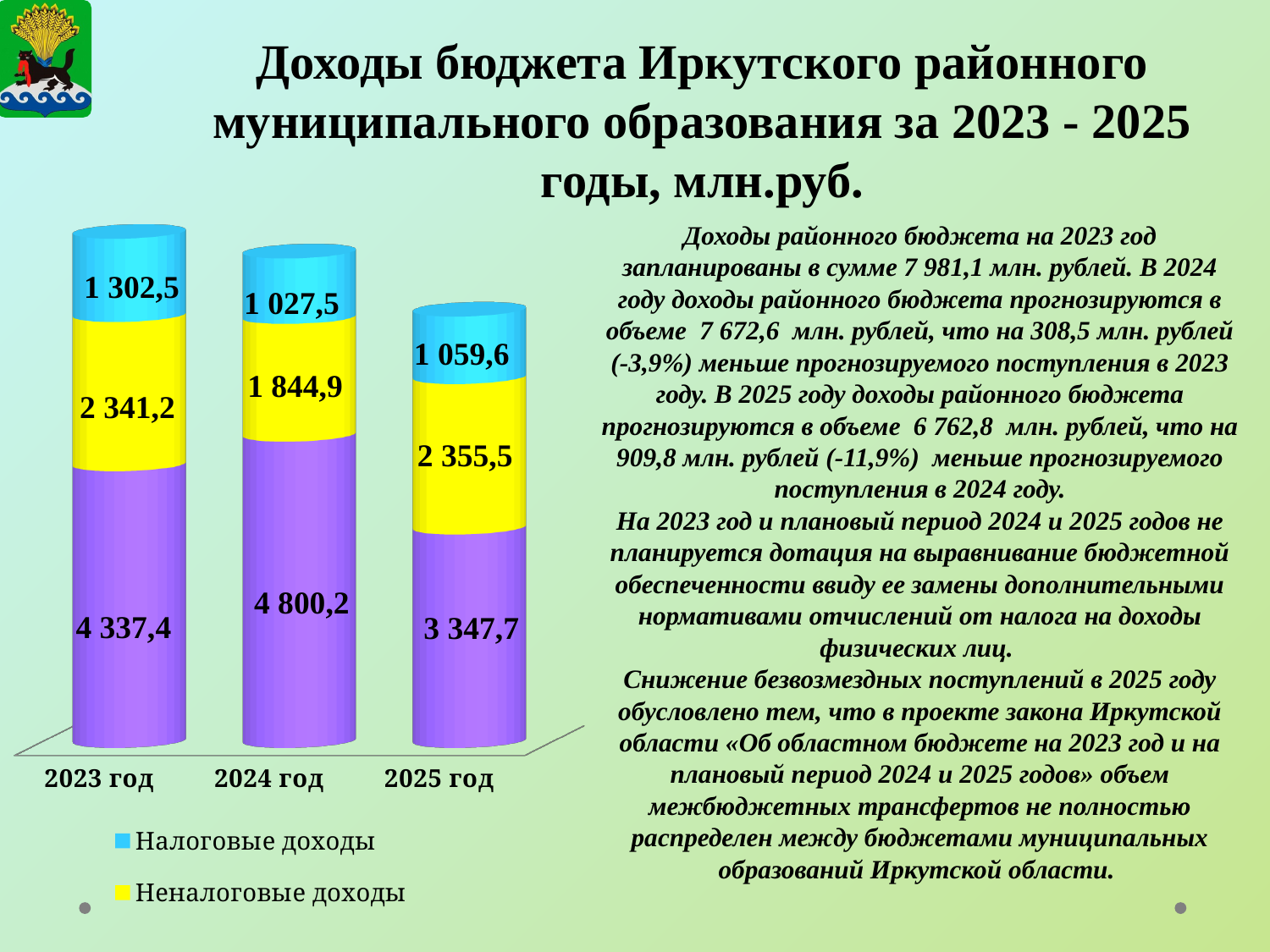
How many years (categories) are shown on the x axis of the chart? 3 By how much does Налоговые доходы in 2023 год exceed Налоговые доходы in 2024 год? 275,0 Which is larger: Неналоговые доходы in 2023 год or in 2025 год? 2025 год What kind of chart is shown on the slide? stacked bar chart Do the total heights of the stacked bars rise or fall from 2023 год to 2025 год? fall What is the value of Налоговые доходы for 2023 год? 1 302,5 In which year is Налоговые доходы the highest? 2023 год In which year is Неналоговые доходы the lowest? 2024 год Which colour represents Неналоговые доходы in the chart? yellow What is the value of Неналоговые доходы for 2024 год? 1 844,9 What is the value of the purple (bottom) segment for 2025 год? 3 347,7 What is the total of the stacked bar for 2024 год? 7 672,6